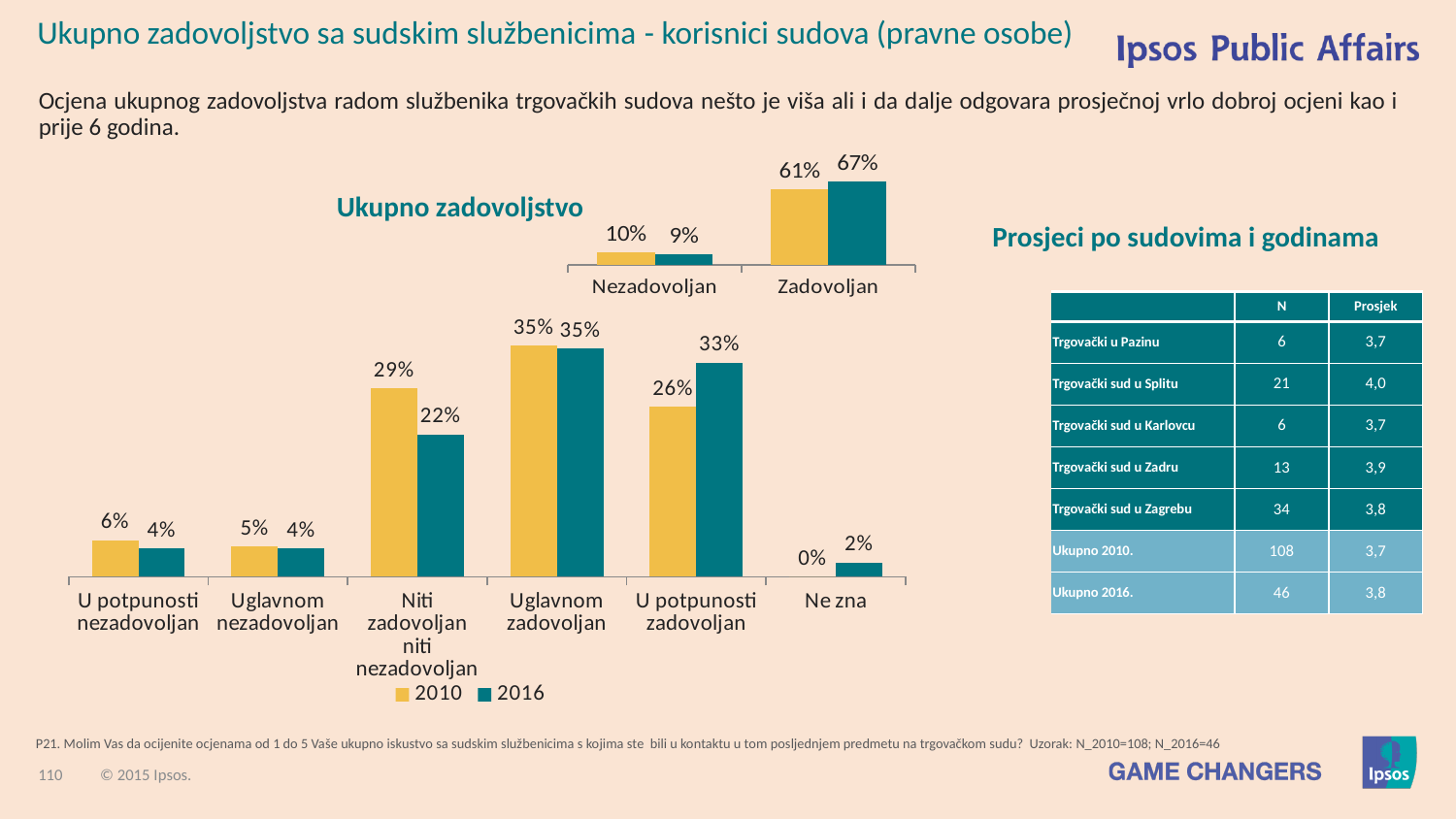
In the large bar chart, what is the difference between the 2010 and 2016 values for 'Niti zadovoljan niti nezadovoljan'? 7% What type of chart is the 'Ukupno zadovoljstvo' chart? Bar chart How many categories are shown on the x axis of the large bar chart? 6 In the 'Ukupno zadovoljstvo' chart, what is the 2016 value for 'Zadovoljan'? 67% In the 'Ukupno zadovoljstvo' chart, what is the difference between the 2016 and 2010 values for 'Zadovoljan'? 6% In the large bar chart, what is the 2010 value for 'Niti zadovoljan niti nezadovoljan'? 29% In the large bar chart, which category has the lowest 2016 value? Ne zna How many series does the legend of the large bar chart list? 2 In the large bar chart, which is larger for 'U potpunosti zadovoljan': the 2010 value or the 2016 value? 2016 In the large bar chart, what is the 2016 value for 'U potpunosti zadovoljan'? 33% In the large bar chart, which colour represents the 2016 series? Teal In the large bar chart, which category has the highest 2010 value? Uglavnom zadovoljan